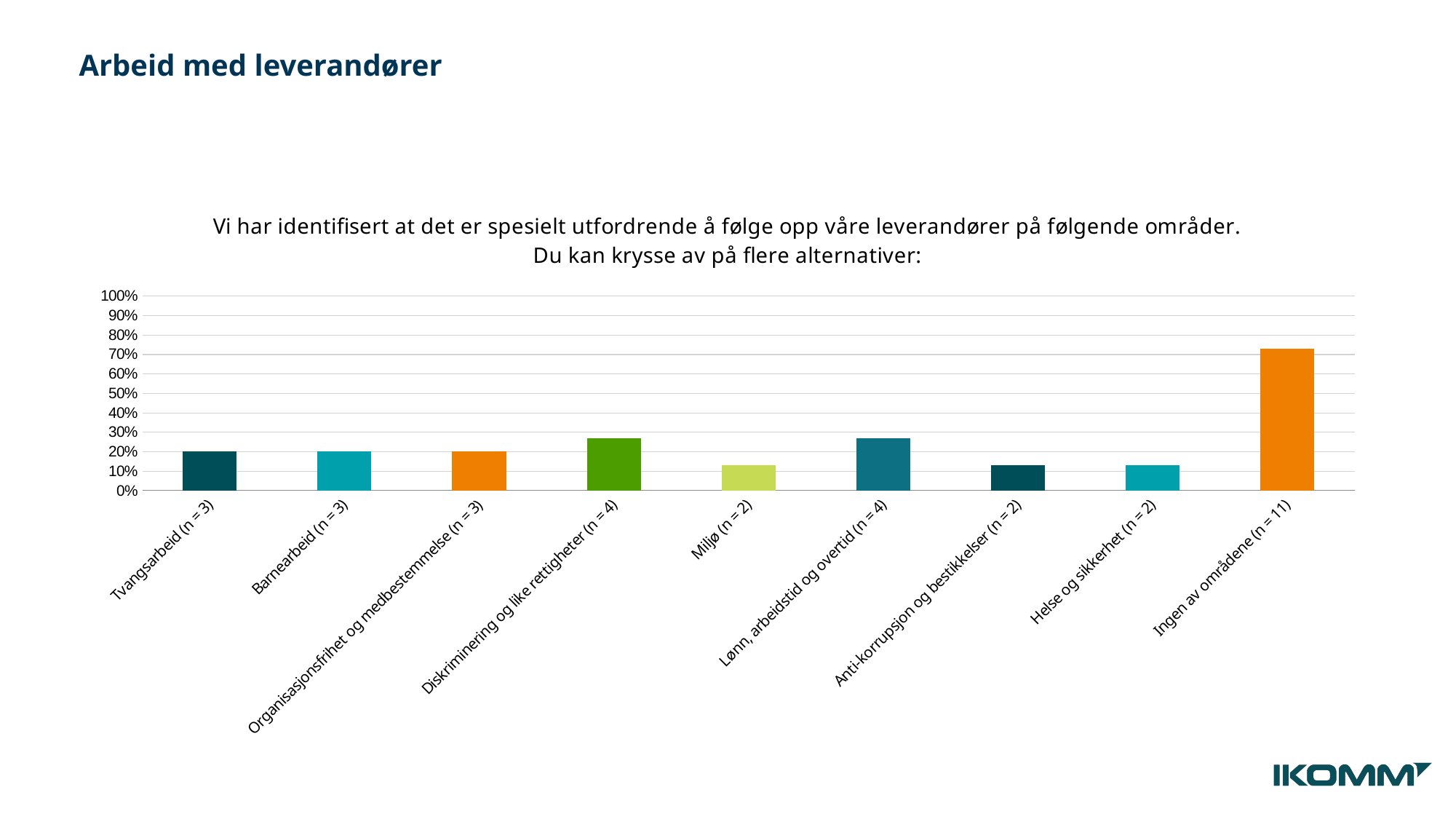
Is the value for Ingen av områdene (n = 11) greater or less than 80%? less What type of chart is shown on the slide? Bar chart Which category has the highest value in the chart? Ingen av områdene (n = 11) Is the value for Diskriminering og like rettigheter (n = 4) greater or less than 20%? greater Is the value for Ingen av områdene (n = 11) greater or less than 70%? greater Which is larger, the value for Tvangsarbeid (n = 3) or the value for Helse og sikkerhet (n = 2)? Tvangsarbeid (n = 3) What is the highest value shown on the y axis of the chart? 100% Which is larger, the value for Lønn, arbeidstid og overtid (n = 4) or the value for Anti-korrupsjon og bestikkelser (n = 2)? Lønn, arbeidstid og overtid (n = 4) How many categories are shown on the x axis of the chart? 9 What value does the bar for Barnearbeid (n = 3) reach on the y axis? 20% What colour is the bar for Ingen av områdene (n = 11)? Orange